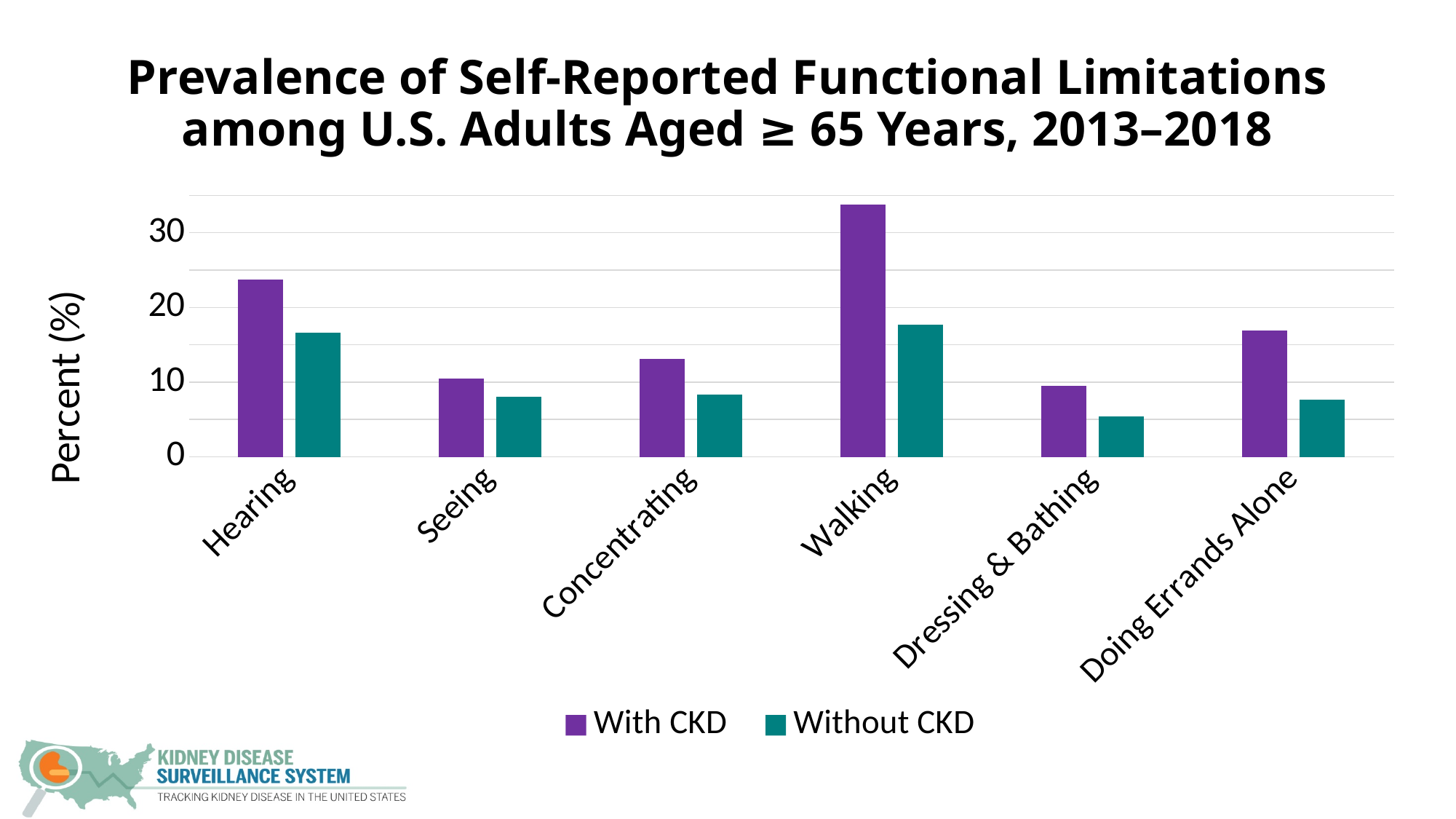
How many functional limitation categories are shown on the x axis? 6 Is the value for Seeing Without CKD greater or less than 10? less Which category has the lowest value for With CKD? Dressing & Bathing What is the label of the y axis? Percent (%) What kind of chart is shown on the slide? bar chart How many series does the legend list? 2 For Walking, which is larger: With CKD or Without CKD? With CKD Is the value for Walking With CKD greater or less than 30? greater Which category has the highest value for With CKD? Walking Which category has the lowest value for Without CKD? Dressing & Bathing Is the value for Doing Errands Alone With CKD greater or less than 20? less